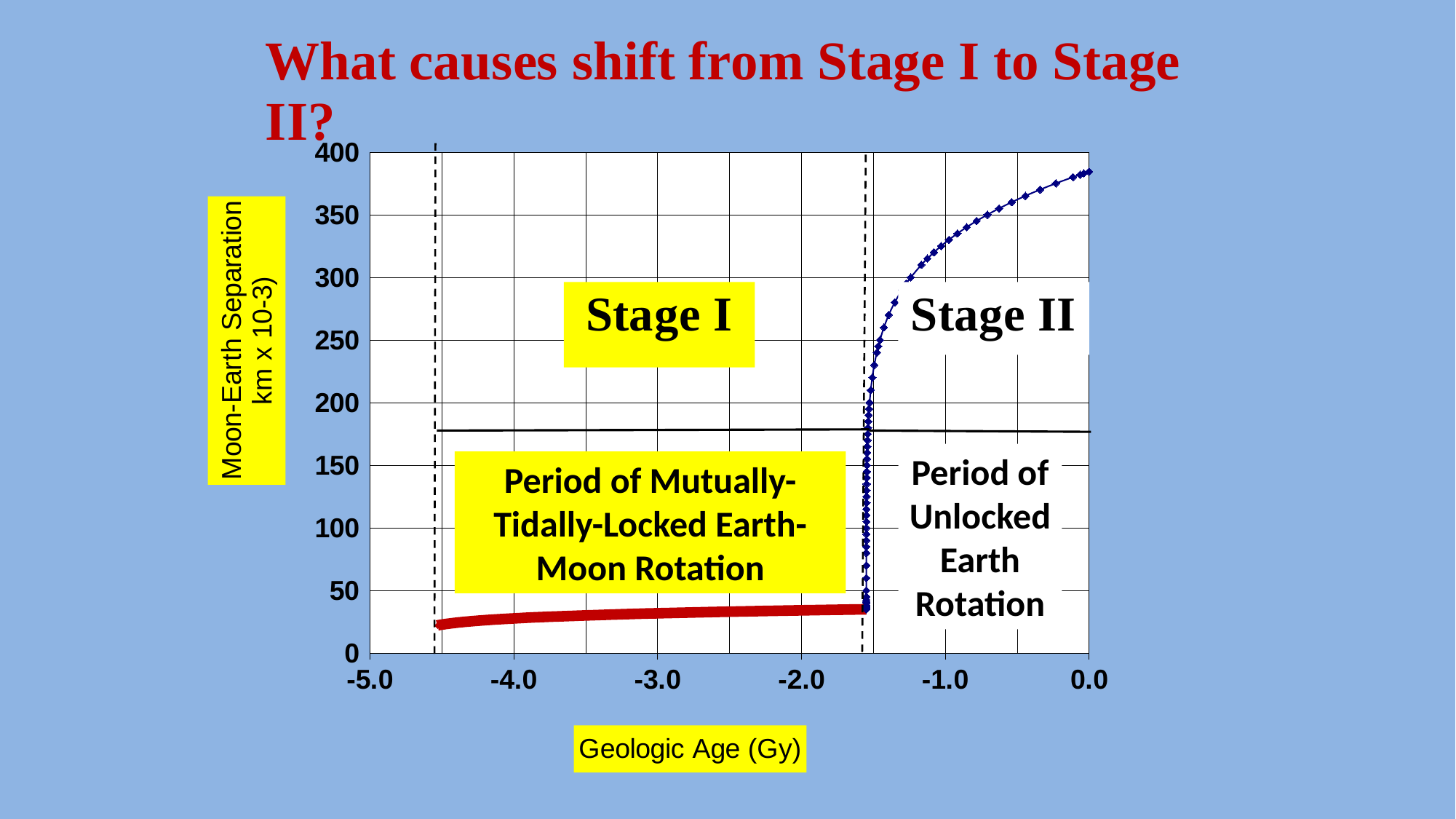
Does the Moon-Earth separation rise or fall as geologic age moves from -5.0 toward 0.0? rise Is the Moon-Earth separation at geologic age -3.0 greater or less than 100? less Which stage is labelled on the right side of the chart, after the steep rise? Stage II Is the Moon-Earth separation at geologic age -4.0 greater or less than 50? less How many labelled tick marks are on the x axis? 6 What is the label of the x axis? Geologic Age (Gy) What kind of chart is shown on the slide? line chart Is the Moon-Earth separation at geologic age -1.0 greater or less than 300? greater What is the label of the y axis? Moon-Earth Separation km x 10-3) Which geologic age has the higher Moon-Earth separation, -2.0 or 0.0? 0.0